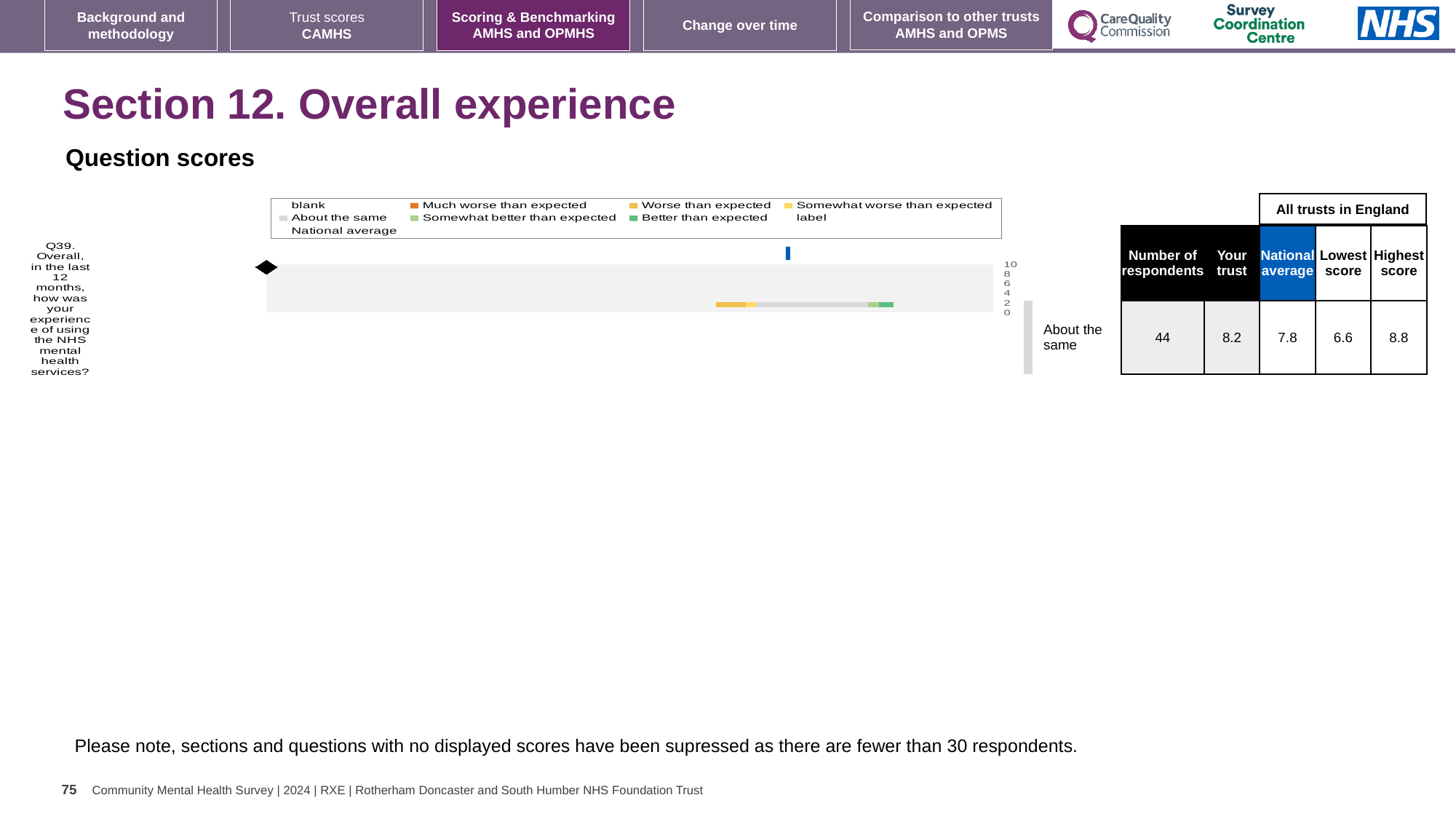
What is the 'Your trust' score for Q39 (Overall, in the last 12 months, how was your experience of using the NHS mental health services?)? 8.2 How many respondents answered Q39? 44 What kind of chart is shown on this slide? Bar chart Which is higher for Q39: the trust's score or the national average? Your trust (8.2) What is the national average score for Q39? 7.8 What is the difference between the highest and lowest scores for Q39 across all trusts in England? 2.2 What is the lowest score among all trusts in England for Q39? 6.6 What benchmark category is the trust's score for Q39 assigned to? About the same How many questions are plotted in the chart on this slide? 1 What is the highest value shown on the chart's score axis? 10 What is the highest score among all trusts in England for Q39? 8.8 By how much does the trust's score for Q39 exceed the national average? 0.4